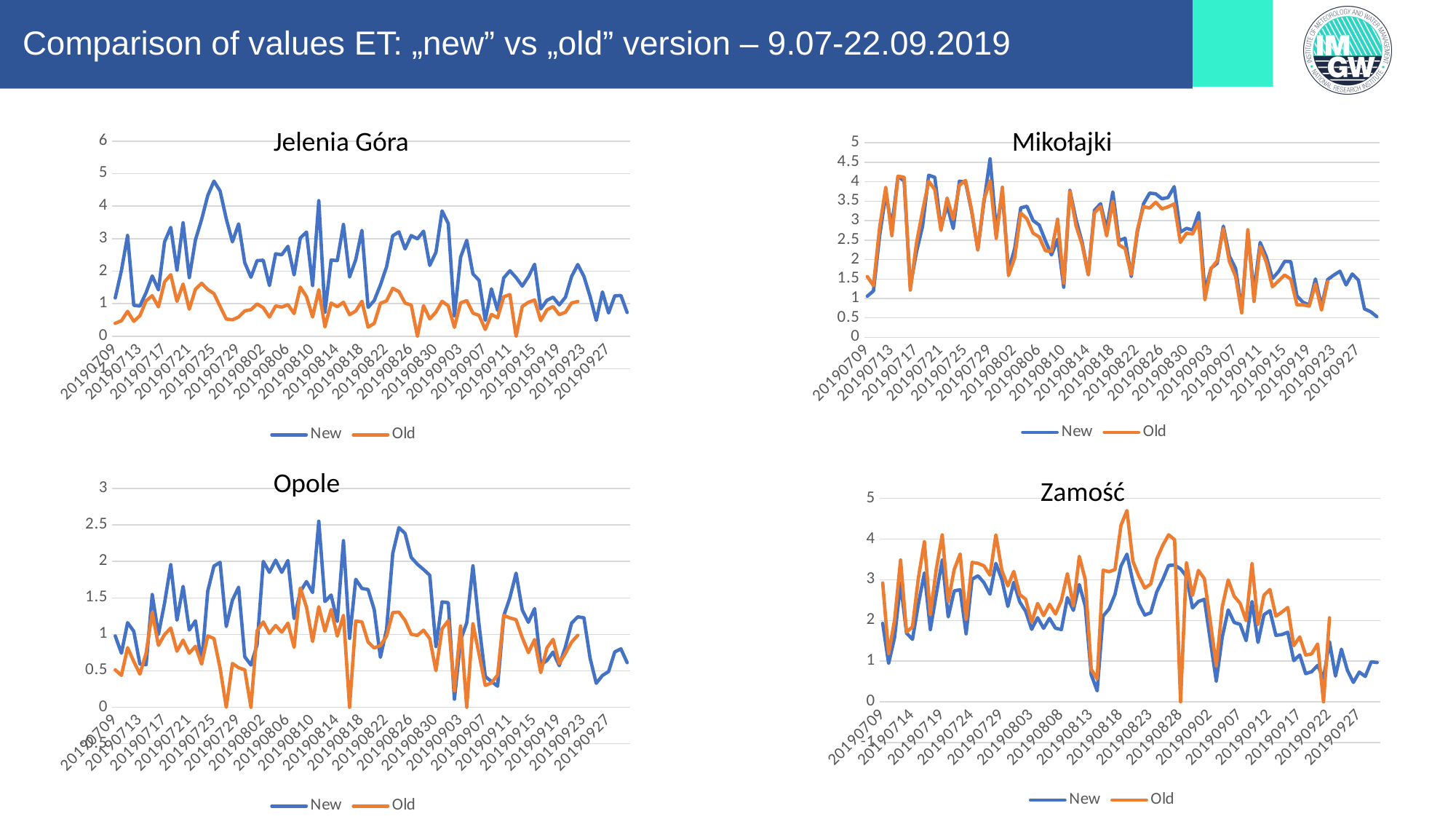
What are the legend entries in the Opole chart? New, Old In the Jelenia Góra chart, which series generally has the higher values, New or Old? New What kind of chart is the Jelenia Góra chart? line chart What is the title of the chart in the bottom-left of the slide? Opole In the Zamość chart, which series reaches the higher peak, New or Old? Old In the Mikołajki chart, do the New series values generally rise or fall from 20190826 to 20190927? fall In the Mikołajki chart, is the highest value of the New series greater or less than 4? greater In the Jelenia Góra chart, is the highest value of the New series greater or less than 4? greater How many charts are shown on the slide? 4 In the Zamość chart, is the highest value of the Old series greater or less than 4? greater How many series does the legend of the Mikołajki chart list? 2